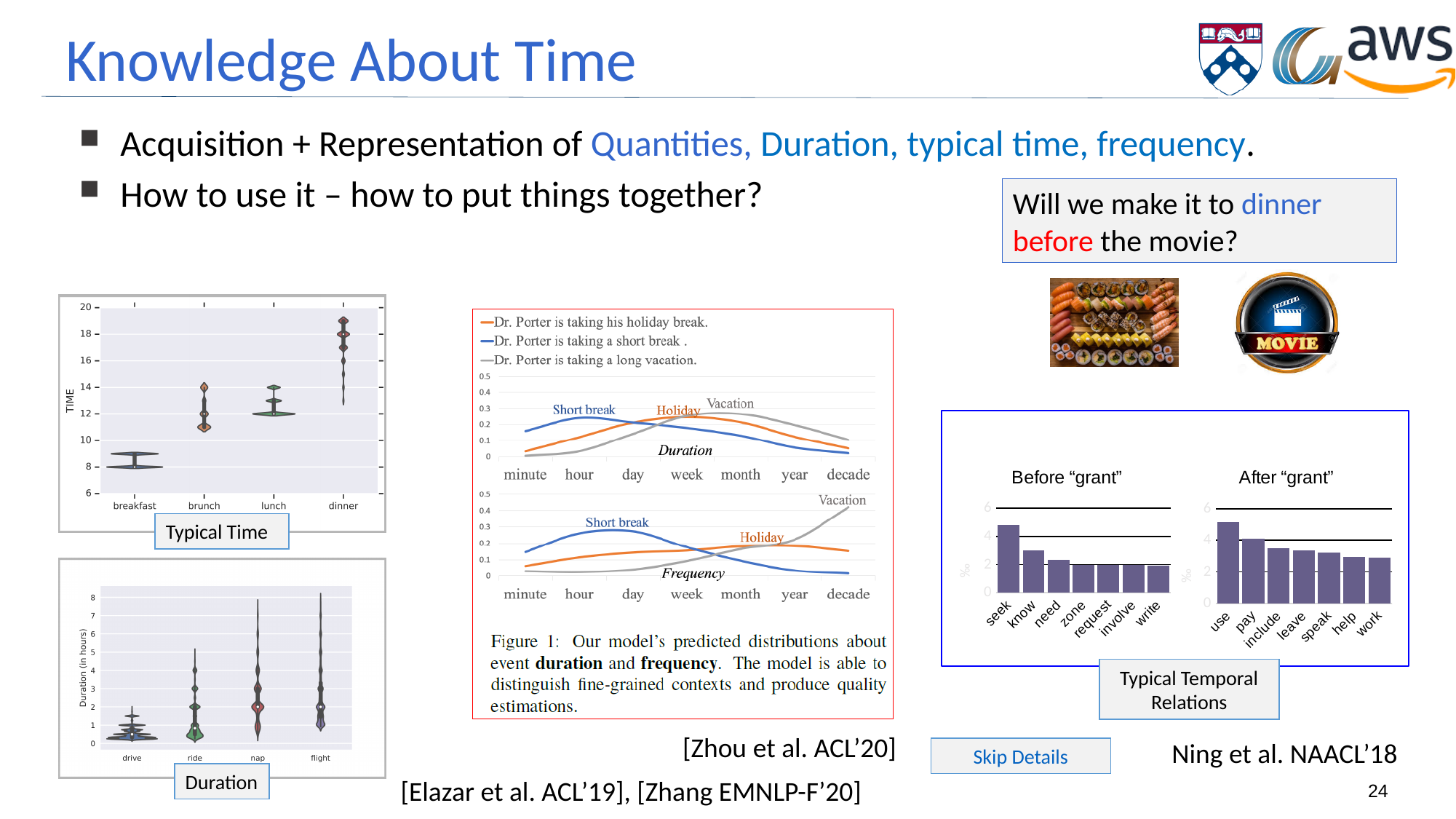
In the Zhou et al. Frequency line chart, which series has the highest value at decade? Vacation In the Duration chart (bottom left), what are the four activity categories on the x axis? drive, ride, nap, flight In the Before "grant" bar chart, which word has the highest value? seek What kind of chart is the Before "grant" chart in the Typical Temporal Relations panel? bar chart In the Typical Time chart, is the typical time for breakfast greater or less than 10? less In the Zhou et al. figure in the middle of the slide, how many series does the legend list? 3 In the Zhou et al. Frequency line chart, how many points are on the x axis from minute to decade? 7 In the Typical Time chart, which meal has the highest typical time? dinner In the Typical Time chart, how many meal categories are shown on the x axis? 4 In the Typical Time chart, which meal has the lowest typical time? breakfast In the Typical Time chart, is the typical time for dinner greater or less than 16? greater In the Duration chart (bottom left), which activity has the shortest typical duration? drive